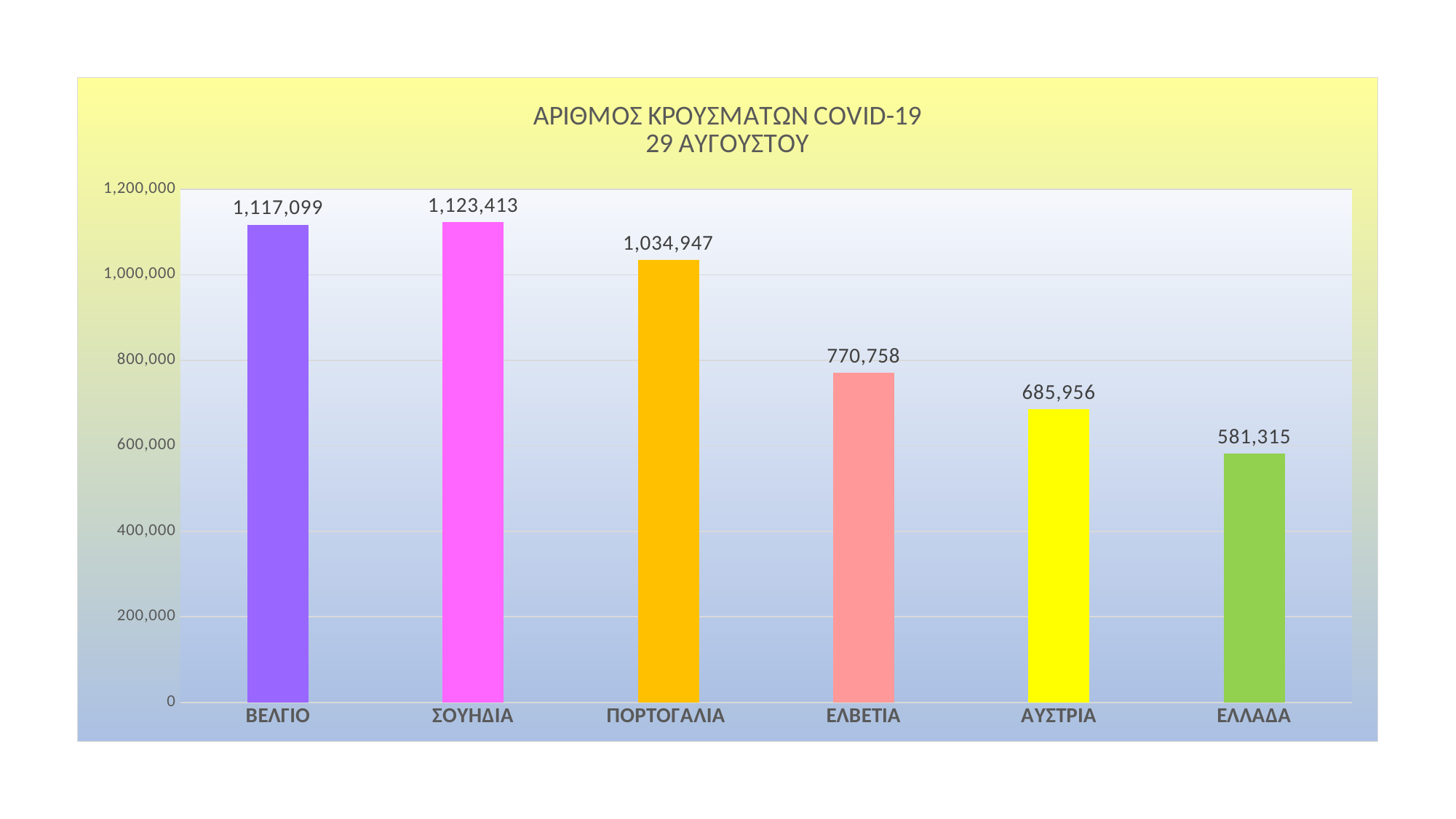
How many countries are shown in the chart? 6 What is the value for ΕΛΒΕΤΙΑ? 770,758 What is the title of the chart? ΑΡΙΘΜΟΣ ΚΡΟΥΣΜΑΤΩΝ COVID-19 29 ΑΥΓΟΥΣΤΟΥ From ΠΟΡΤΟΓΑΛΙΑ to ΕΛΛΑΔΑ, do the values rise or fall along the x axis? fall What is the difference between the values for ΕΛΒΕΤΙΑ and ΑΥΣΤΡΙΑ? 84,802 Which country has the lowest value? ΕΛΛΑΔΑ Which is larger, the value for ΠΟΡΤΟΓΑΛΙΑ or the value for ΕΛΒΕΤΙΑ? ΠΟΡΤΟΓΑΛΙΑ What is the value for ΒΕΛΓΙΟ? 1,117,099 What type of chart is shown on the slide? bar chart Which country has the highest value? ΣΟΥΗΔΙΑ What is the value for ΕΛΛΑΔΑ? 581,315 Is the value for ΑΥΣΤΡΙΑ greater or less than 800,000? less